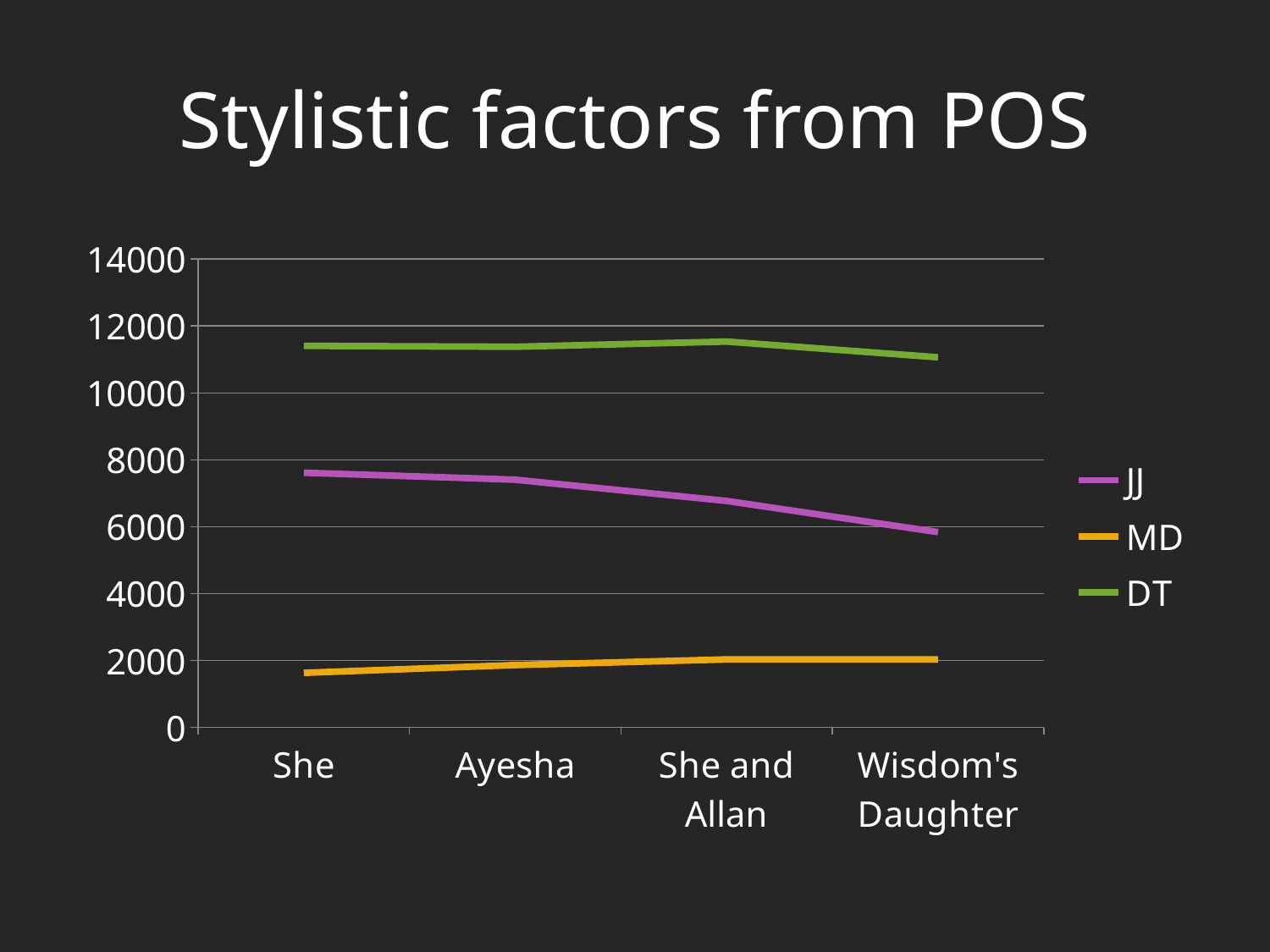
For which category is the JJ series lowest? Wisdom's Daughter How many categories are shown on the x axis? 4 Is the MD value for She greater or less than 2000? less What is the title of the chart? Stylistic factors from POS Is the JJ value for Wisdom's Daughter greater or less than 8000? less Is the DT value for She greater or less than 10000? greater For which category is the MD series lowest? She How many series does the legend list? 3 What kind of chart is shown on the slide? line chart Which series is drawn in green? DT Does the JJ series rise or fall from She to Wisdom's Daughter? fall